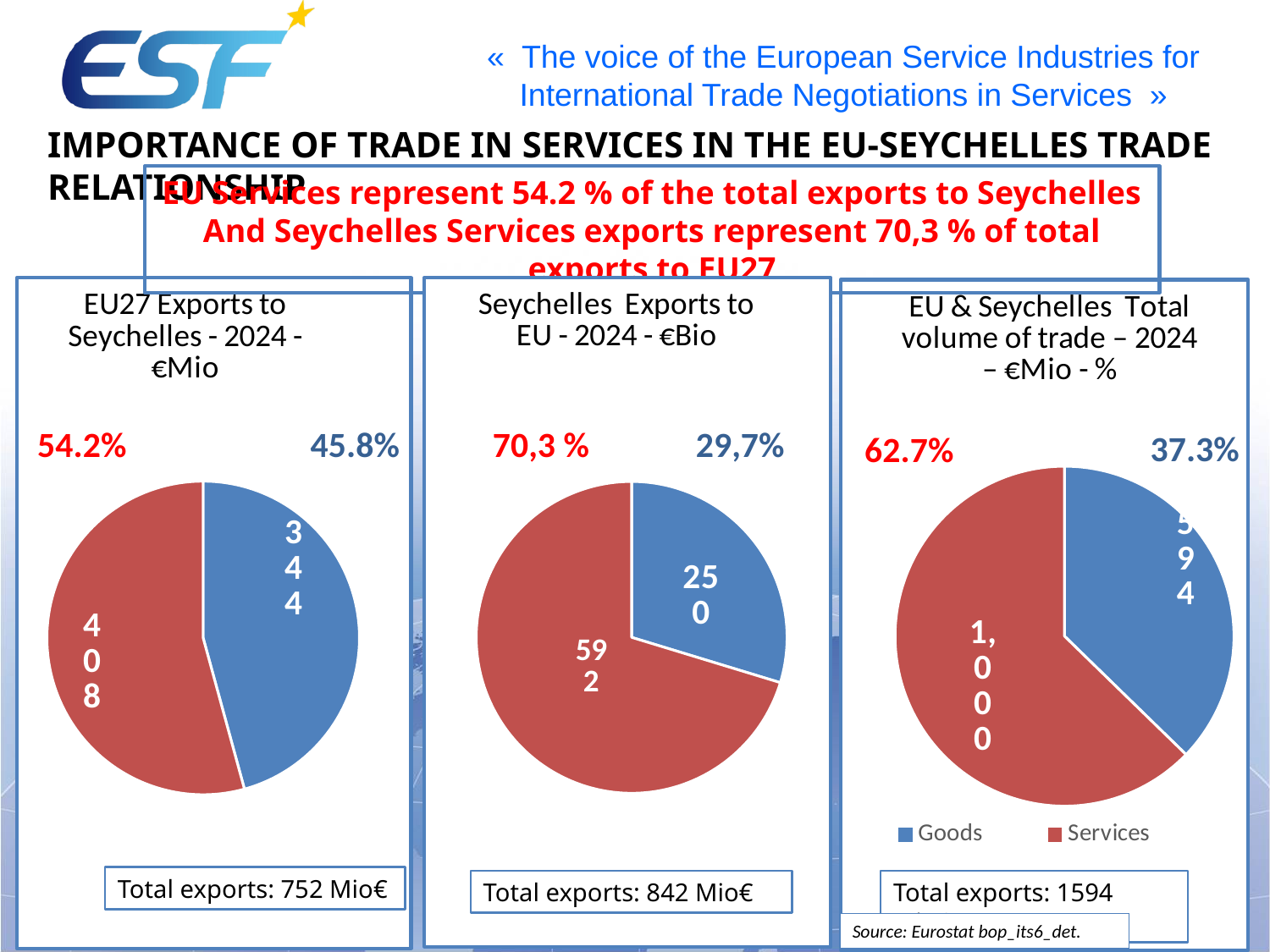
What kind of chart is the 'EU27 Exports to Seychelles - 2024 - €Mio' chart? pie chart How many entries does the legend of the 'EU & Seychelles Total volume of trade – 2024' chart list? 2 In the 'Seychelles Exports to EU - 2024 - €Bio' chart, what is the total of the two slices? 842 Mio€ In the 'Seychelles Exports to EU - 2024 - €Bio' chart, what is the value of the Services (red) slice? 592 In the 'EU27 Exports to Seychelles - 2024 - €Mio' chart, what is the difference between the Services value and the Goods value? 64 In the 'EU27 Exports to Seychelles - 2024 - €Mio' chart, what share of the pie is Services? 54.2% In the 'EU & Seychelles Total volume of trade – 2024' chart, which category has the larger slice? Services In the 'EU & Seychelles Total volume of trade – 2024' chart, what is the value of the Services slice? 1,000 In the 'EU27 Exports to Seychelles - 2024 - €Mio' chart, what is the value of the Goods (blue) slice? 344 In the 'EU & Seychelles Total volume of trade – 2024' chart, what share of the pie is Goods? 37.3% In the 'Seychelles Exports to EU - 2024 - €Bio' chart, what share of the pie is Goods? 29,7% In the 'EU27 Exports to Seychelles - 2024 - €Mio' chart, what is the value of the Services (red) slice? 408